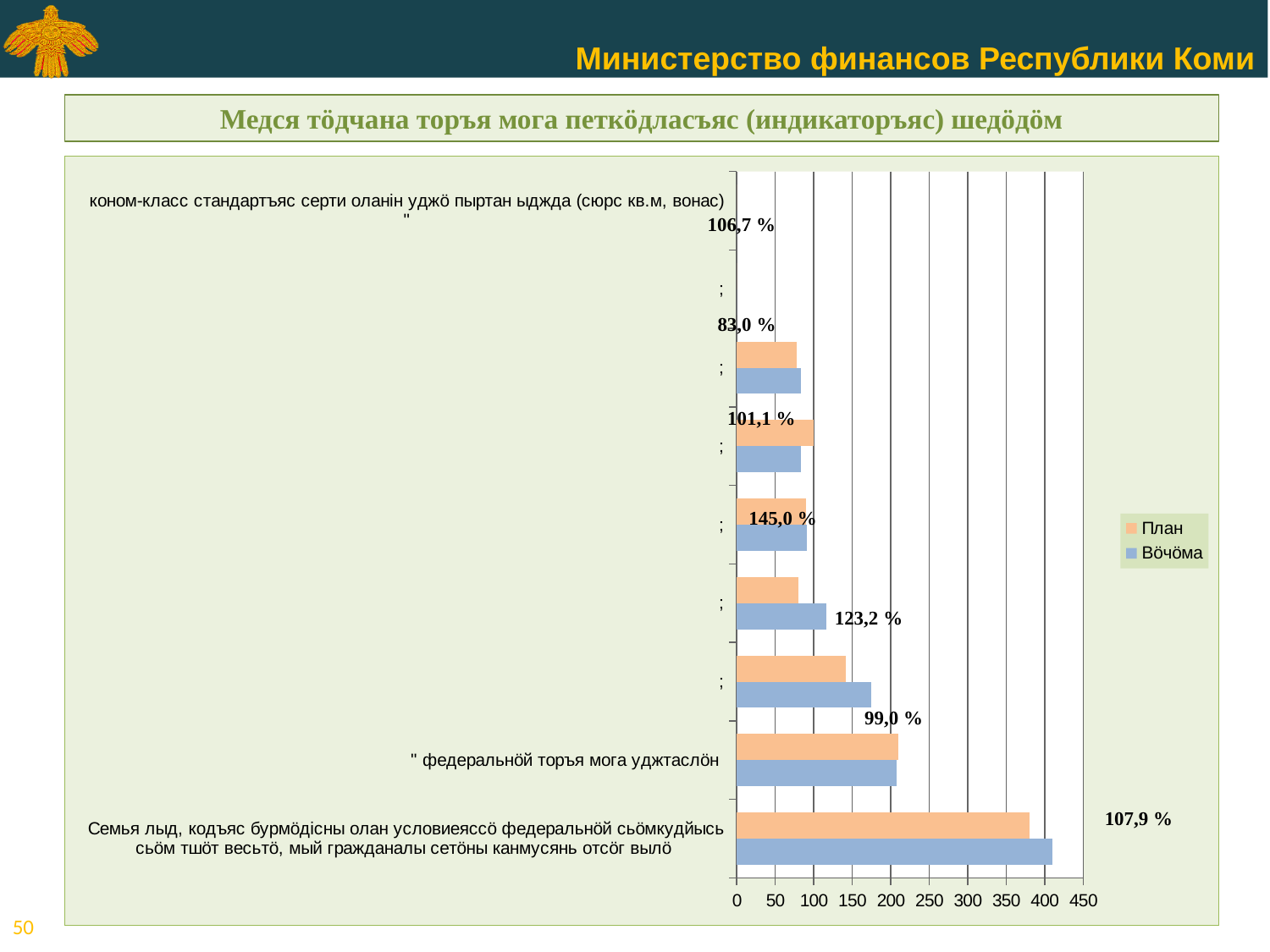
Is the План value for the category 'федеральнöй торъя мога уджтаслöн' greater or less than 150? greater Which category has the longest План bar? Семья лыд, кодъяс бурмöдісны олан условиеяссö федеральнöй сьöмкудйысь сьöм тшöт весьтö, мый гражданалы сетöны канмусянь отсöг вылö Is the Вöчöма value for the category 'Семья лыд, кодъяс бурмöдісны олан условиеяссö федеральнöй сьöмкудйысь сьöм тшöт весьтö, мый гражданалы сетöны канмусянь отсöг вылö' greater or less than 300? greater Which category has the longest Вöчöма bar? Семья лыд, кодъяс бурмöдісны олан условиеяссö федеральнöй сьöмкудйысь сьöм тшöт весьтö, мый гражданалы сетöны канмусянь отсöг вылö What are the two series named in the chart legend? План and Вöчöма Is the План value for the category 'Семья лыд, кодъяс бурмöдісны олан условиеяссö федеральнöй сьöмкудйысь сьöм тшöт весьтö, мый гражданалы сетöны канмусянь отсöг вылö' greater or less than 300? greater What kind of chart is shown on the slide? bar chart How many series does the chart legend list? 2 For the category 'Семья лыд, кодъяс бурмöдісны олан условиеяссö федеральнöй сьöмкудйысь сьöм тшöт весьтö, мый гражданалы сетöны канмусянь отсöг вылö', which series has the larger value, План or Вöчöма? Вöчöма What is the highest value shown on the chart's horizontal axis? 450 Which colour represents the План series in the chart? orange